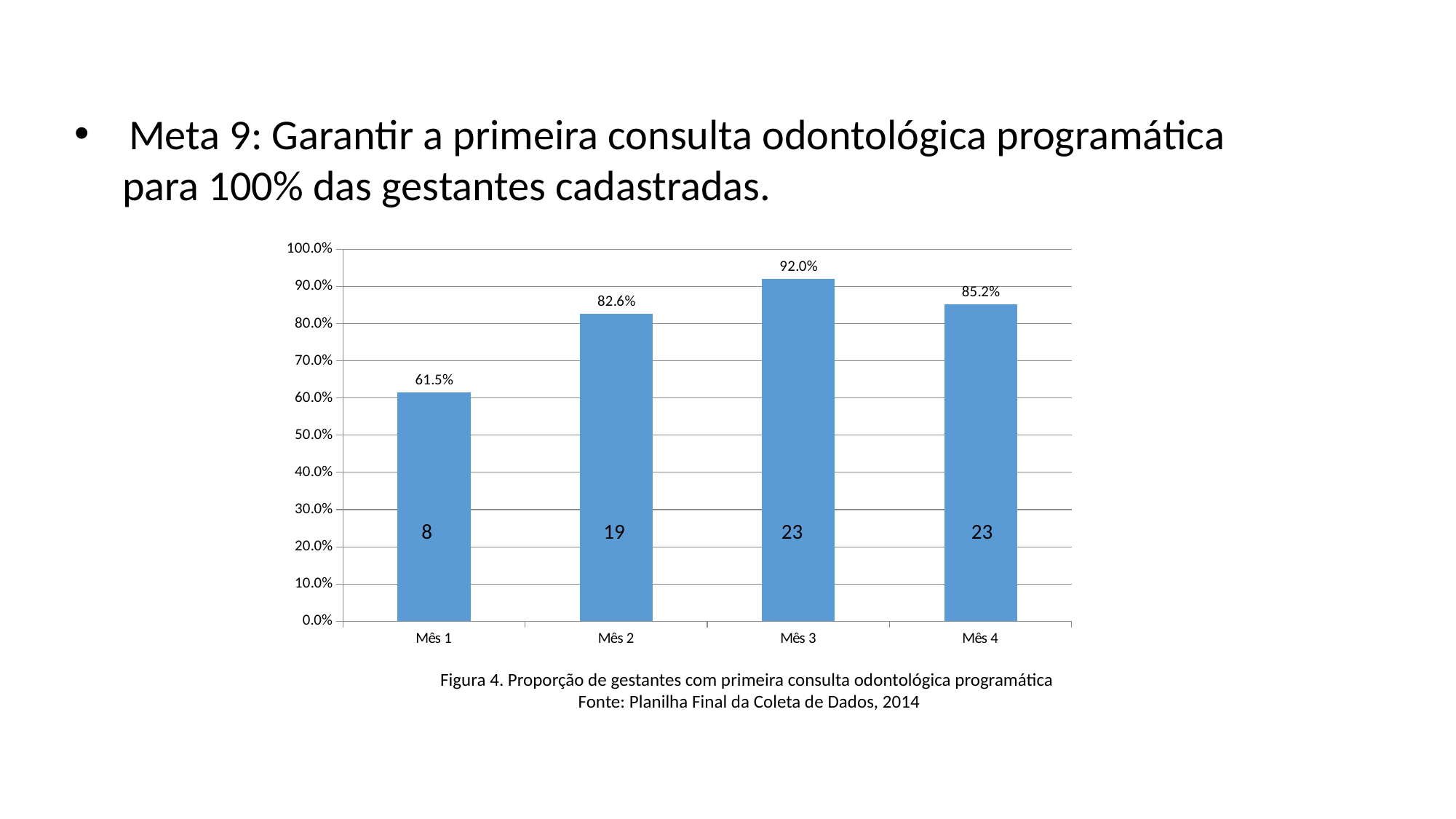
Is the value for Mês 2 greater or less than 80.0%? greater What kind of chart is shown on the slide? Bar chart What is the difference in percentage points between Mês 3 and Mês 1? 30.5 Which has a higher percentage, Mês 2 or Mês 4? Mês 4 Which month has the highest percentage? Mês 3 What count is printed inside the bar for Mês 2? 19 How many months (categories) are shown on the x axis? 4 What count is printed inside the bar for Mês 4? 23 What is the percentage value shown for Mês 1? 61.5% What is the percentage value shown for Mês 3? 92.0% Which month has the lowest percentage? Mês 1 What is the figure caption below the chart? Figura 4. Proporção de gestantes com primeira consulta odontológica programática